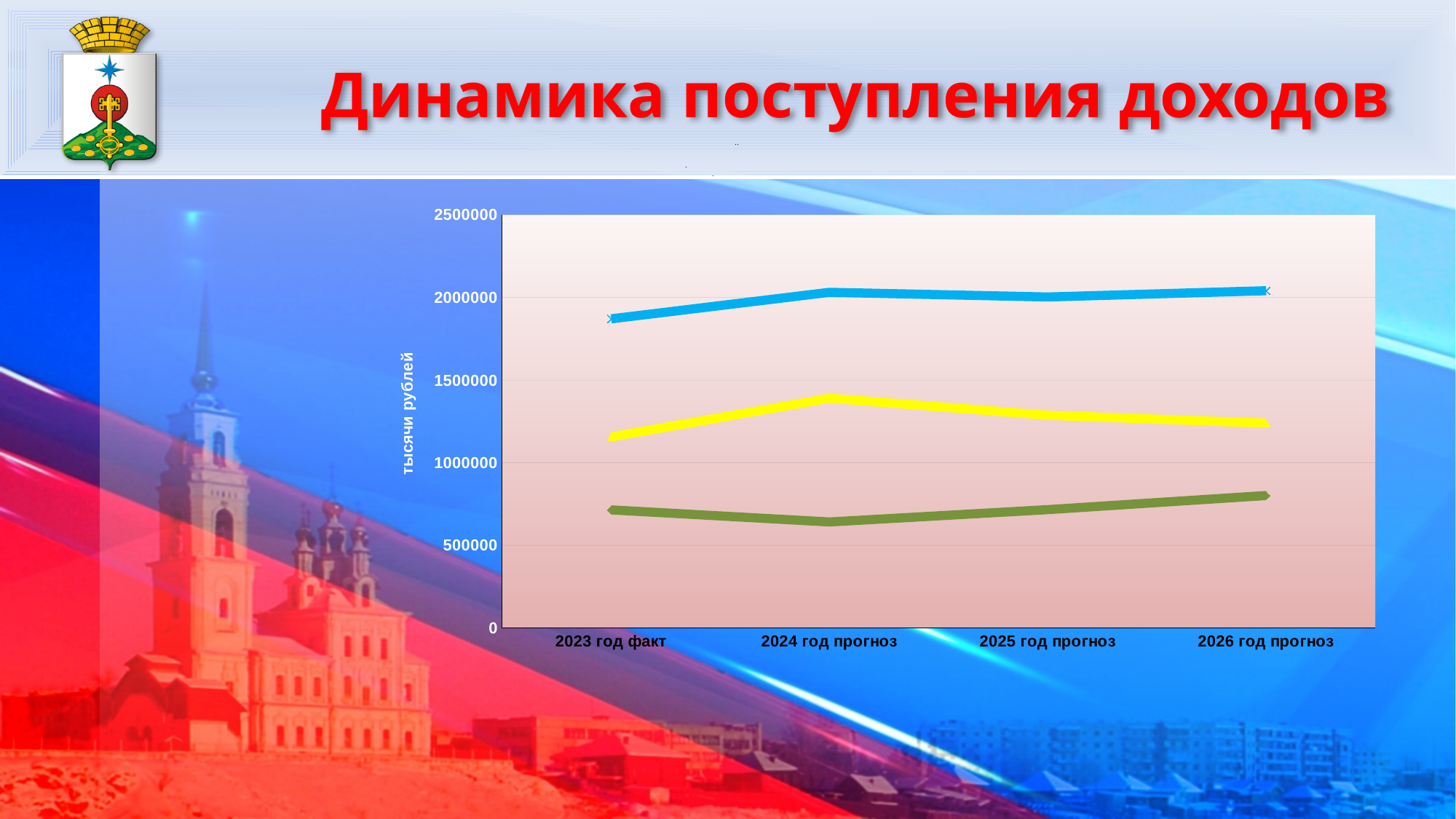
How many lines are plotted on the chart? 3 How many categories are shown on the x axis of the chart? 4 Is the value of the green line for 2026 год прогноз greater or less than 1000000? less Which line has the highest values across all years: blue, yellow or green? blue Is the value of the blue line for 2023 год факт greater or less than 2000000? less What kind of chart is shown on the slide? line chart Is the value of the yellow line for 2024 год прогноз greater or less than 1500000? less Does the green line rise or fall from 2024 год прогноз to 2026 год прогноз? rise What is the label of the vertical axis of the chart? тысячи рублей What is the title of the slide containing the chart? Динамика поступления доходов